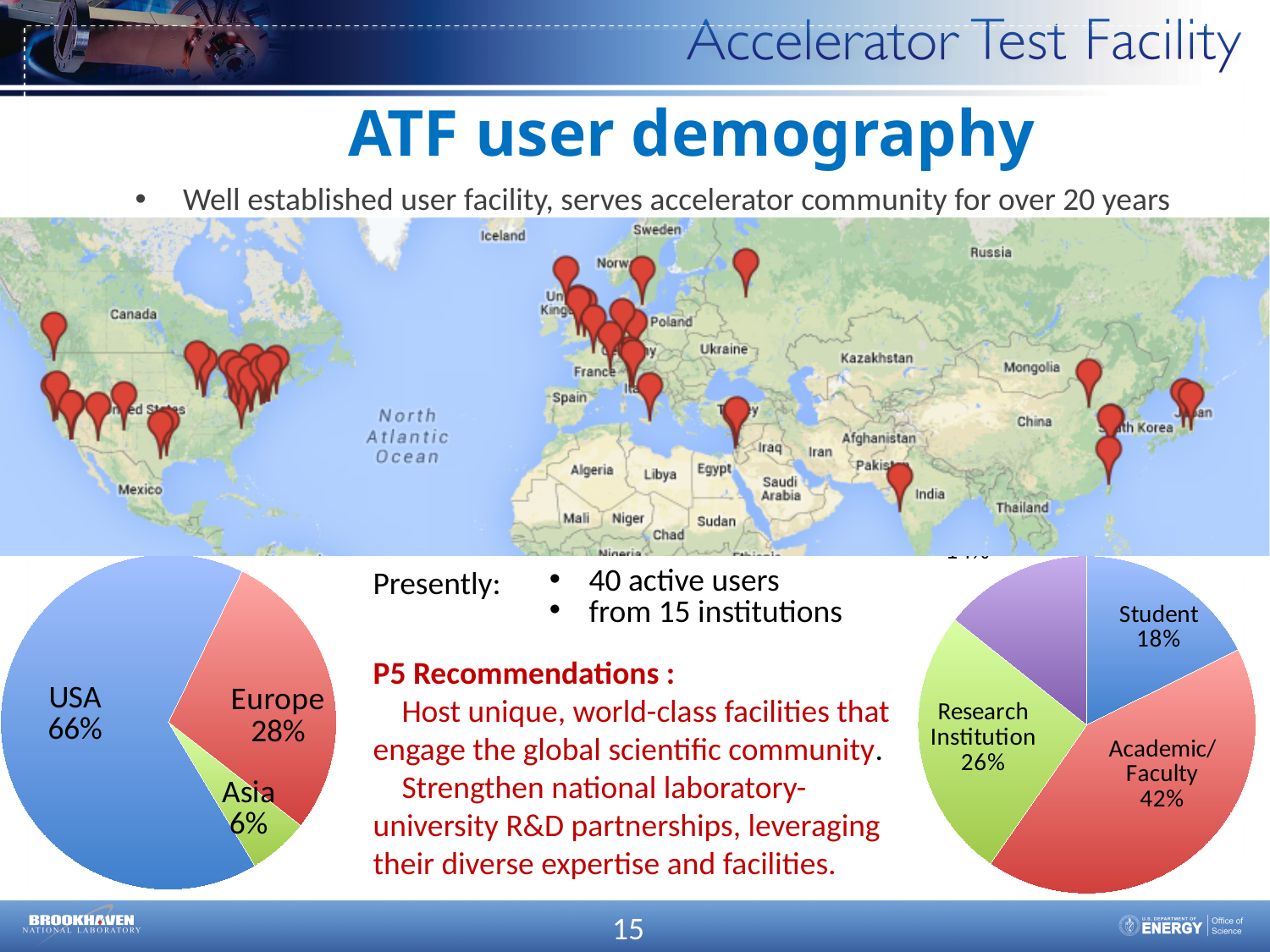
How many slices does the left pie chart have? 3 In the left pie chart, what share of users is from the USA? 66% In the right pie chart, which is larger, the Student share or the Research Institution share? Research Institution In the left pie chart, which region has the largest share? USA In the right pie chart, what share is labelled Student? 18% In the left pie chart, what share of users is from Asia? 6% In the left pie chart, what is the difference between the USA share and the Europe share? 38% In the left pie chart, what share of users is from Europe? 28% In the left pie chart, which region has the smallest share? Asia In the right pie chart, what share is labelled Research Institution? 26% In the right pie chart, what share is labelled Academic/Faculty? 42% What kind of chart is the left chart on the slide? pie chart